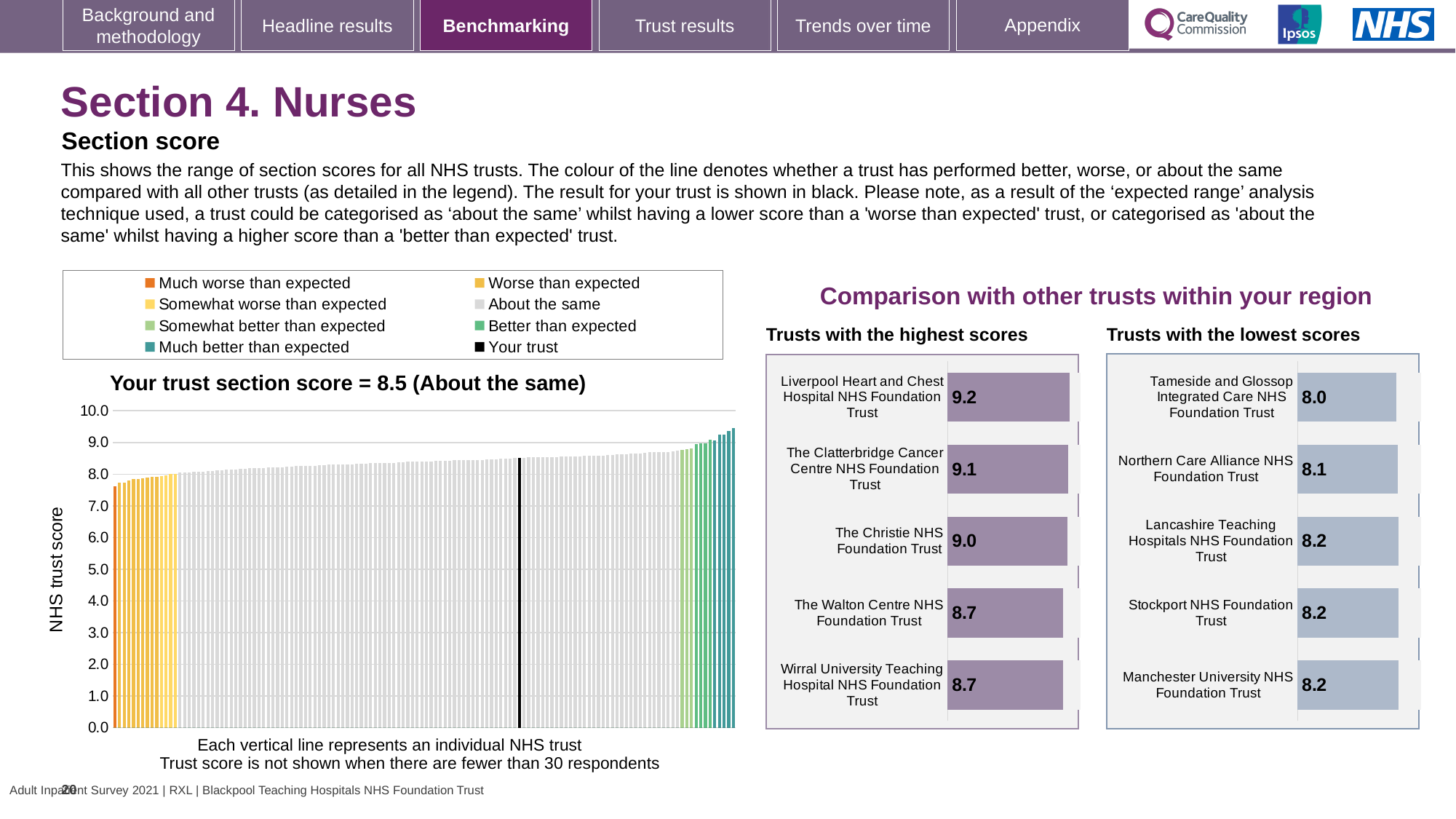
In the 'Your trust section score' chart, is the value of the lowest-scoring trust (the leftmost bar) greater or less than 8.0? less In the 'Trusts with the highest scores' chart, what is the difference between the scores of Liverpool Heart and Chest Hospital NHS Foundation Trust and The Christie NHS Foundation Trust? 0.2 In the 'Your trust section score' chart, is the value of the highest-scoring trust (the rightmost bar) greater or less than 9.0? greater In the 'Trusts with the lowest scores' chart, what is the score for Stockport NHS Foundation Trust? 8.2 In the 'Trusts with the lowest scores' chart, which has the higher score: Northern Care Alliance NHS Foundation Trust or Tameside and Glossop Integrated Care NHS Foundation Trust? Northern Care Alliance NHS Foundation Trust In the 'Your trust section score' chart, what kind of chart is shown? bar chart In the 'Trusts with the highest scores' chart, how many trusts are shown? 5 In the 'Trusts with the highest scores' chart, what is the score for Liverpool Heart and Chest Hospital NHS Foundation Trust? 9.2 In the 'Your trust section score' chart, what is the section score for your trust? 8.5 In the 'Trusts with the lowest scores' chart, which trust has the lowest score? Tameside and Glossop Integrated Care NHS Foundation Trust In the 'Your trust section score' chart, how many entries does the legend list? 8 In the 'Your trust section score' chart, what is the label on the vertical axis? NHS trust score